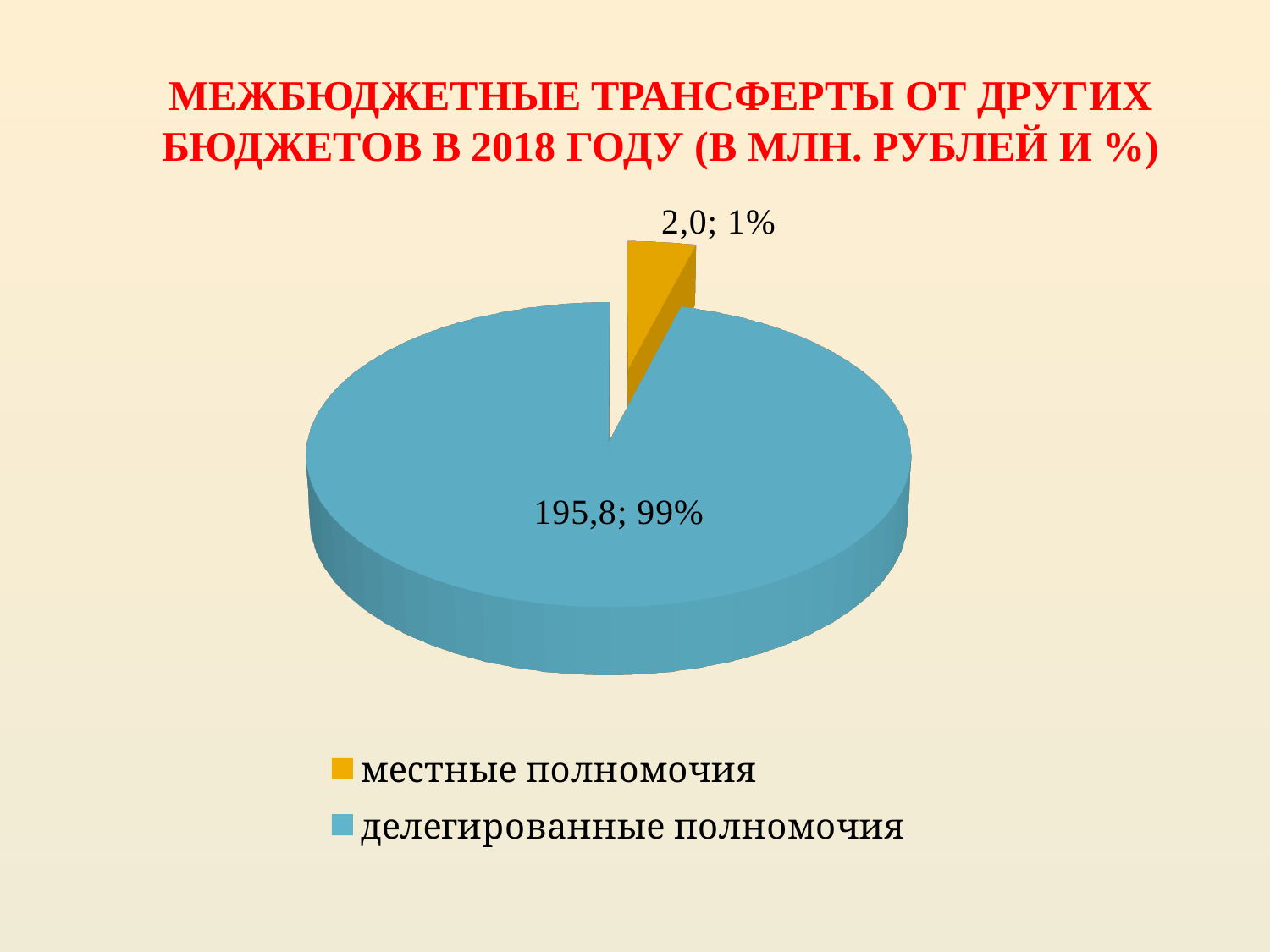
What is the value for местные полномочия? 2,0 Which category has the smallest slice? местные полномочия How many categories does the pie chart have? 2 Which category has the largest slice? делегированные полномочия Which is larger, местные полномочия or делегированные полномочия? делегированные полномочия What share of the pie does местные полномочия take? 1% What is the value for делегированные полномочия? 195,8 What is the total of the two slices? 197,8 What kind of chart is shown on the slide? pie chart What colour is the slice for местные полномочия? yellow What is the difference between the values for делегированные полномочия and местные полномочия? 193,8 What share of the pie does делегированные полномочия take? 99%